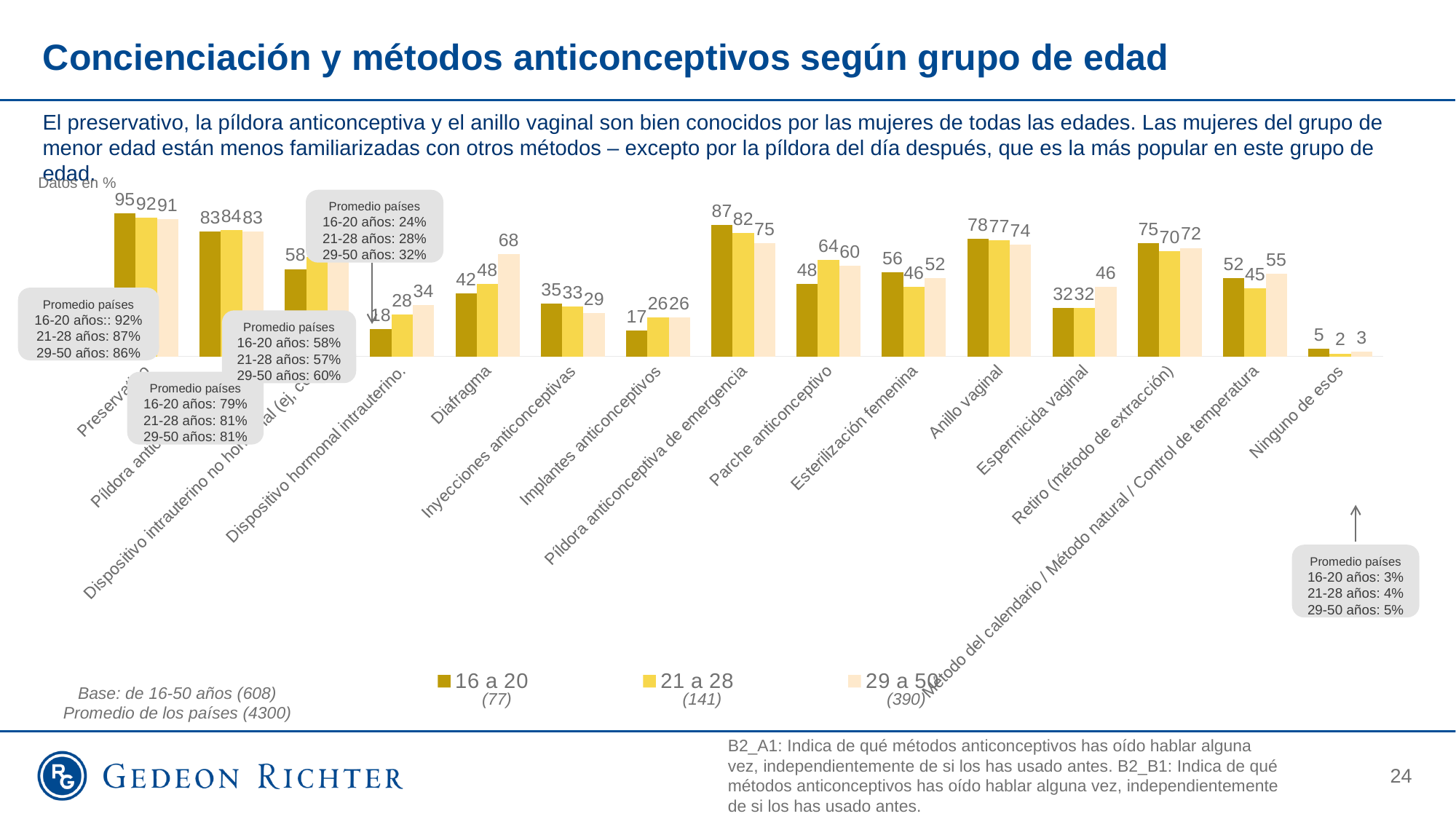
What is the value for Anillo vaginal in the 16 a 20 series? 78 What type of chart is shown on the slide? Bar chart Which is larger for Esterilización femenina: the 16 a 20 value or the 21 a 28 value? 16 a 20 Which age group has the highest value for Píldora anticonceptiva de emergencia? 16 a 20 What is the difference between the 21 a 28 and 16 a 20 values for Implantes anticonceptivos? 9 Which series is shown in the darkest gold colour in the legend? 16 a 20 What is the difference between the 29 a 50 and 16 a 20 values for Espermicida vaginal? 14 Which age group has the lowest value for Dispositivo hormonal intrauterino? 16 a 20 What is the value for Ninguno de esos in the 21 a 28 series? 2 What is the value for Diafragma in the 29 a 50 series? 68 What is the value for Parche anticonceptivo in the 21 a 28 series? 64 How many series does the legend list? 3